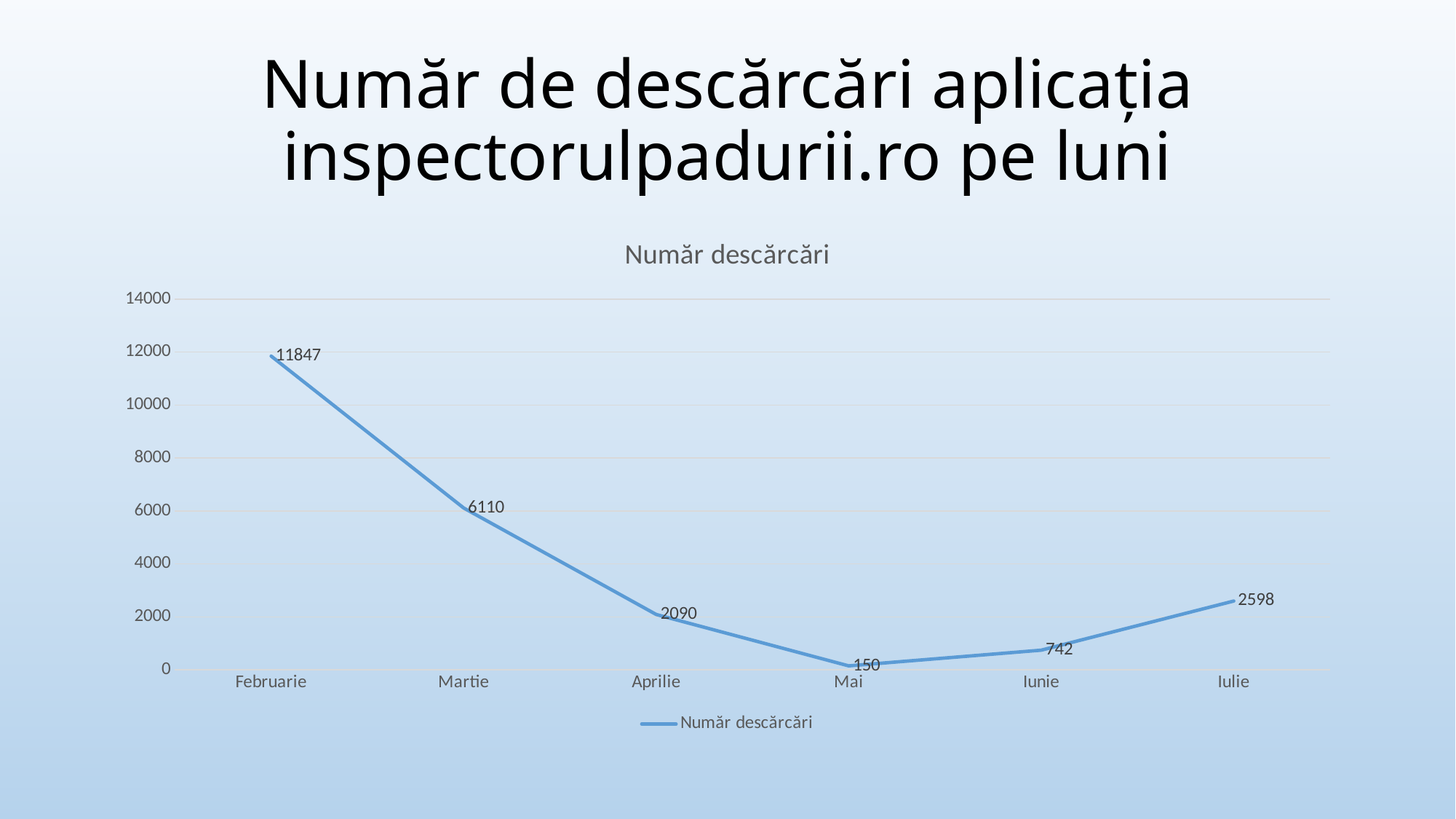
Do the values rise or fall from Februarie to Mai? fall How many series does the legend list? 1 What is the value for Martie? 6110 What is the difference between the values for Februarie and Martie? 5737 Which is larger, the value for Aprilie or the value for Iulie? Iulie What kind of chart is shown on the slide? line chart Which month has the lowest number of downloads? Mai What is the value for Februarie? 11847 What is the value for Iunie? 742 How many months are plotted on the chart? 6 Which month has the highest number of downloads? Februarie What is the difference between the values for Iulie and Iunie? 1856